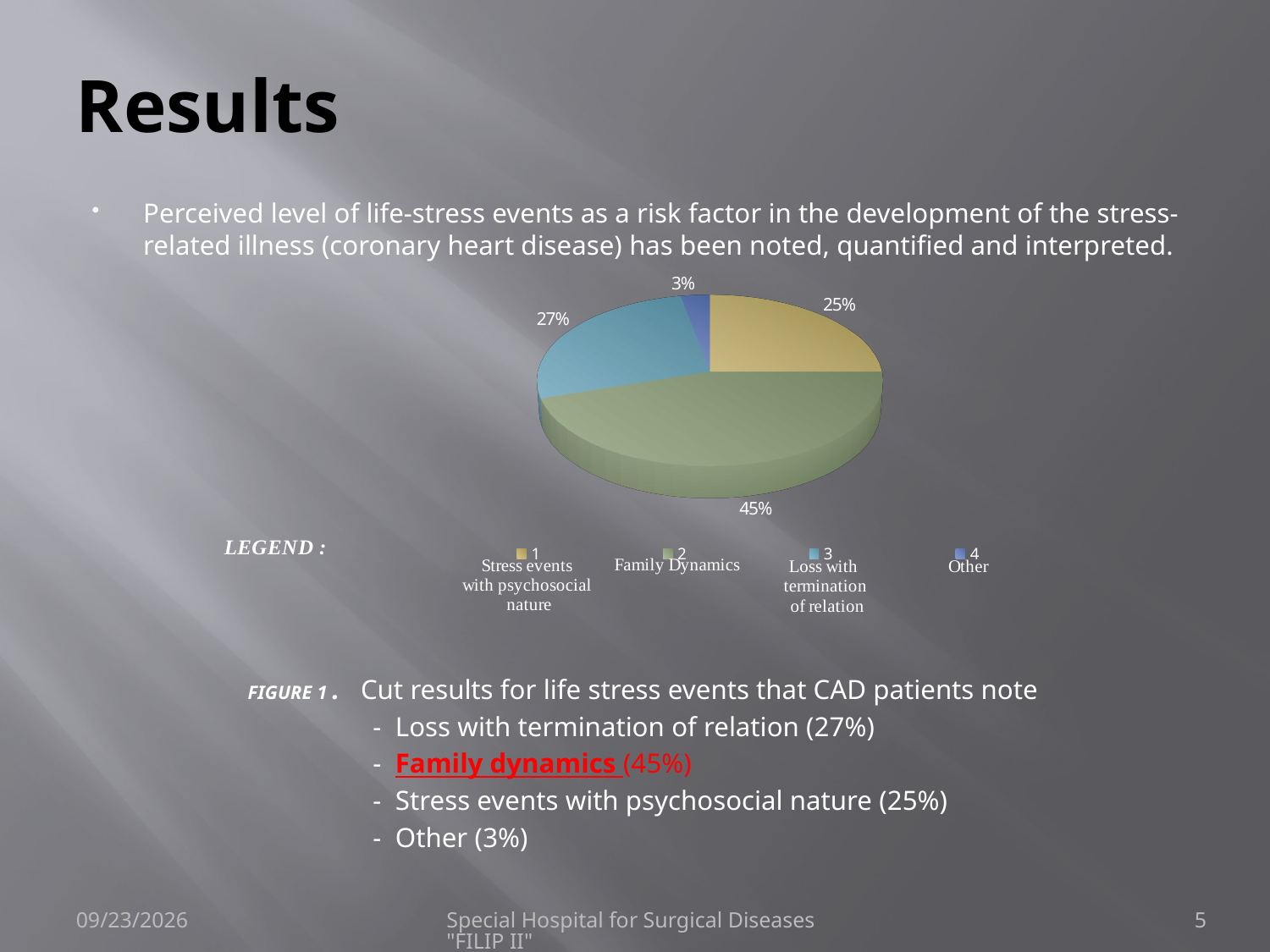
What share of the pie does Other take? 3% Which category has the smallest slice of the pie? Other Which category has the largest slice of the pie? Family Dynamics What colour is the slice for Family Dynamics? green What share of the pie does Family Dynamics take? 45% How many entries does the legend list? 4 What share of the pie does Loss with termination of relation take? 27% How many slices does the pie chart have? 4 What kind of chart is shown on the slide? pie chart Which is larger, the slice for Loss with termination of relation or the slice for Stress events with psychosocial nature? Loss with termination of relation What is the difference in percentage points between Family Dynamics and Loss with termination of relation? 18